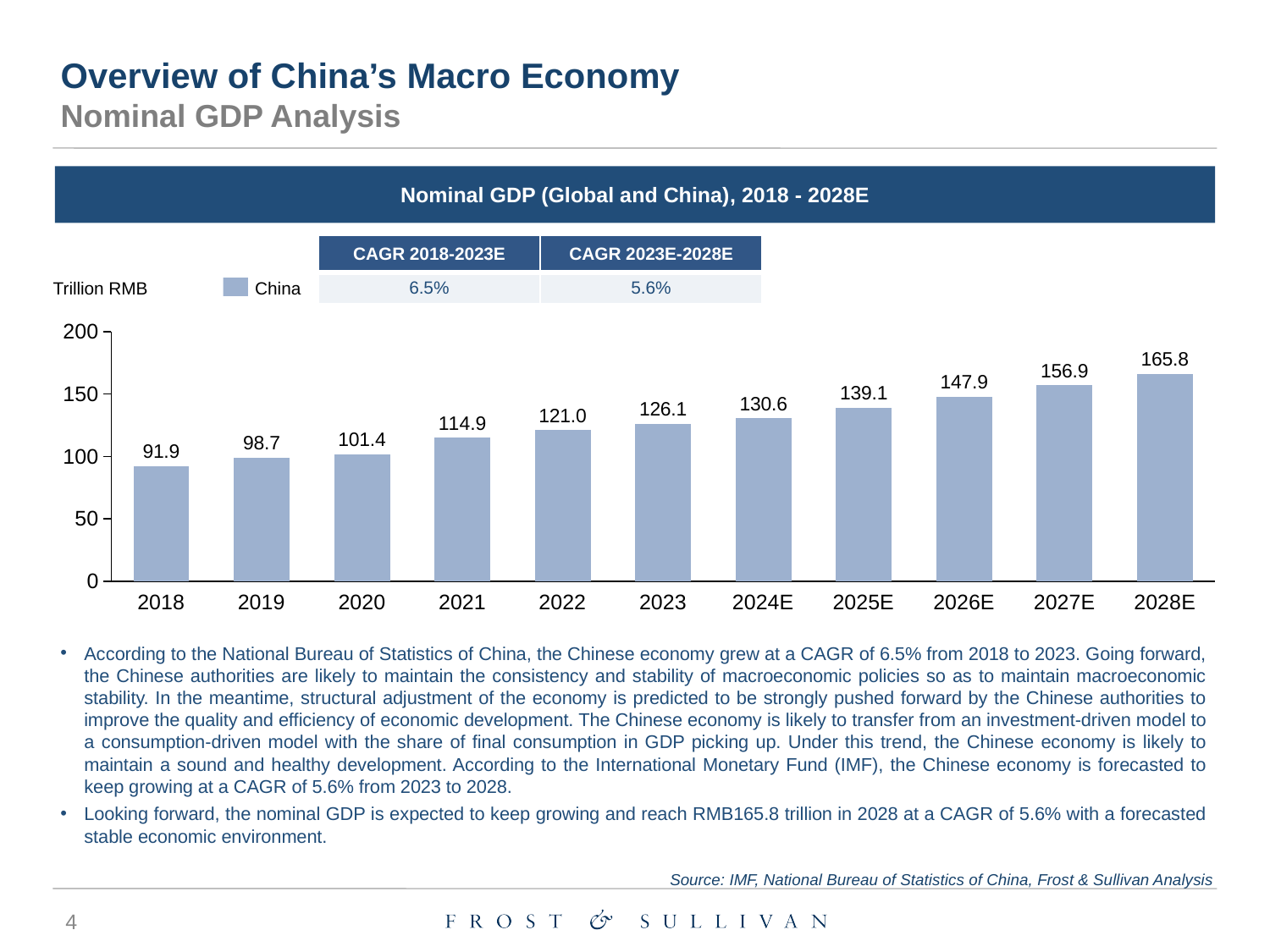
What is the nominal GDP value for 2026E? 147.9 Which year has the lowest nominal GDP value? 2018 Which is larger, the nominal GDP value for 2021 or for 2024E? 2024E What is the difference between the nominal GDP values for 2023 and 2022? 5.1 How many years are shown on the x axis? 11 Which year has the highest nominal GDP value? 2028E What kind of chart is shown on the slide? Bar chart What is the nominal GDP value for 2018? 91.9 Is the value for 2025E greater or less than 150? less Do the nominal GDP values rise or fall from 2018 to 2028E? Rise What is the difference between the nominal GDP values for 2028E and 2018? 73.9 What is the nominal GDP value for 2023? 126.1